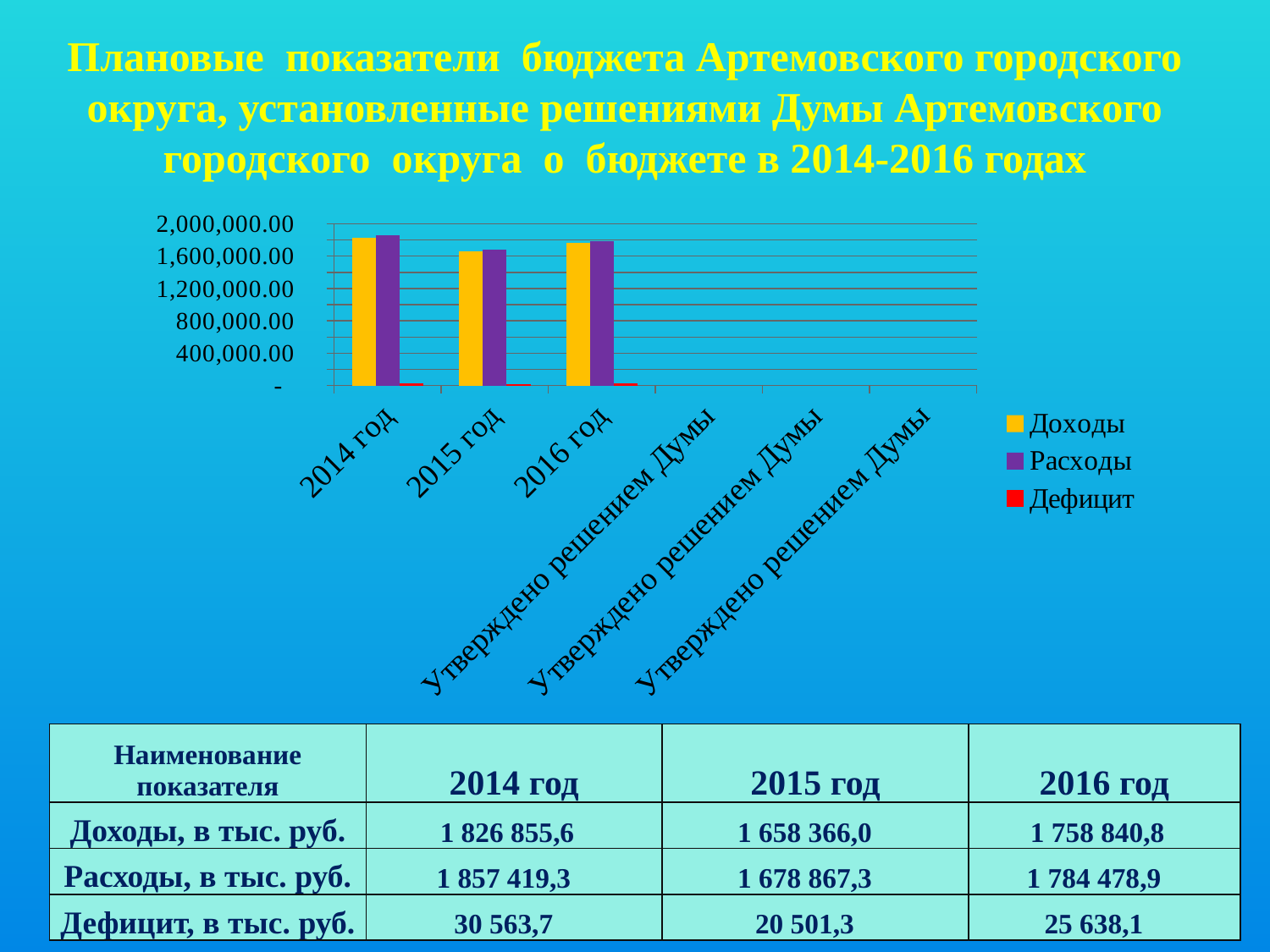
According to the slide, what is the value of Расходы for 2016 год? 1 784 478,9 What kind of chart is shown on the slide? bar chart What is the difference between Доходы in 2014 год and Доходы in 2016 год? 68 014,8 According to the slide, what is the value of Дефицит for 2015 год? 20 501,3 For 2014 год, which is larger: Доходы or Расходы? Расходы Is the value of Дефицит for 2014 год greater or less than 400,000.00? less How many series does the chart legend list? 3 For how many years are bars plotted in the chart? 3 According to the slide, what is the value of Доходы for 2014 год? 1 826 855,6 In which year is Доходы the lowest? 2015 год Which colour represents Дефицит in the chart legend? red In which year is Расходы the highest? 2014 год